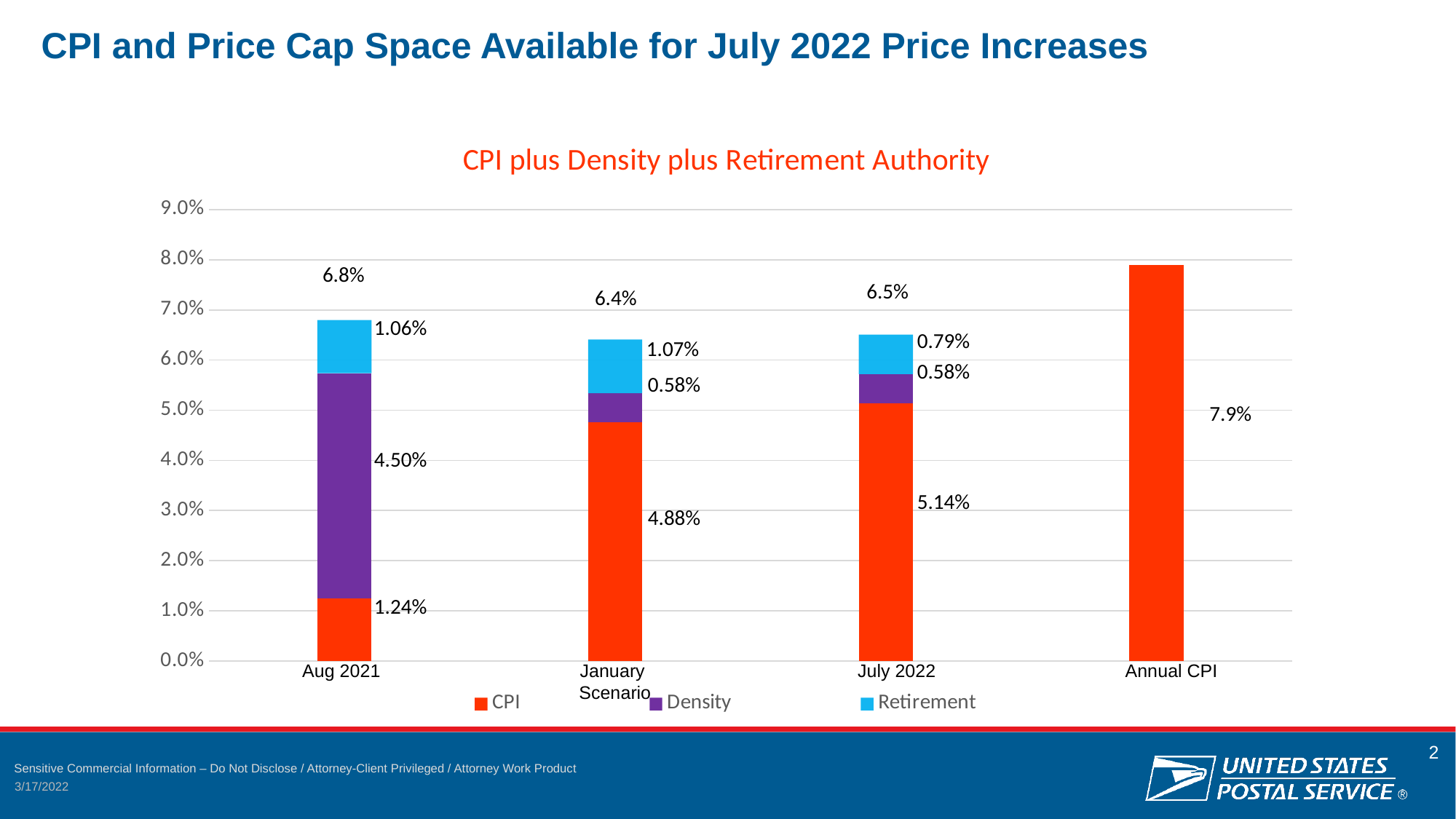
What is the total of the stacked bar for July 2022? 6.5% Which category has the lowest CPI value? Aug 2021 How many series does the legend list? 3 Which category has the highest total value? Annual CPI Which is larger, the Retirement value for Aug 2021 or for July 2022? Aug 2021 What type of chart is shown on the slide? Stacked bar chart What is the CPI value for Aug 2021? 1.24% What is the difference between the CPI values for July 2022 and the January Scenario? 0.26% What is the Density value for Aug 2021? 4.50% What is the value shown for Annual CPI? 7.9% What is the CPI value for July 2022? 5.14% What is the Retirement value for the January Scenario? 1.07%